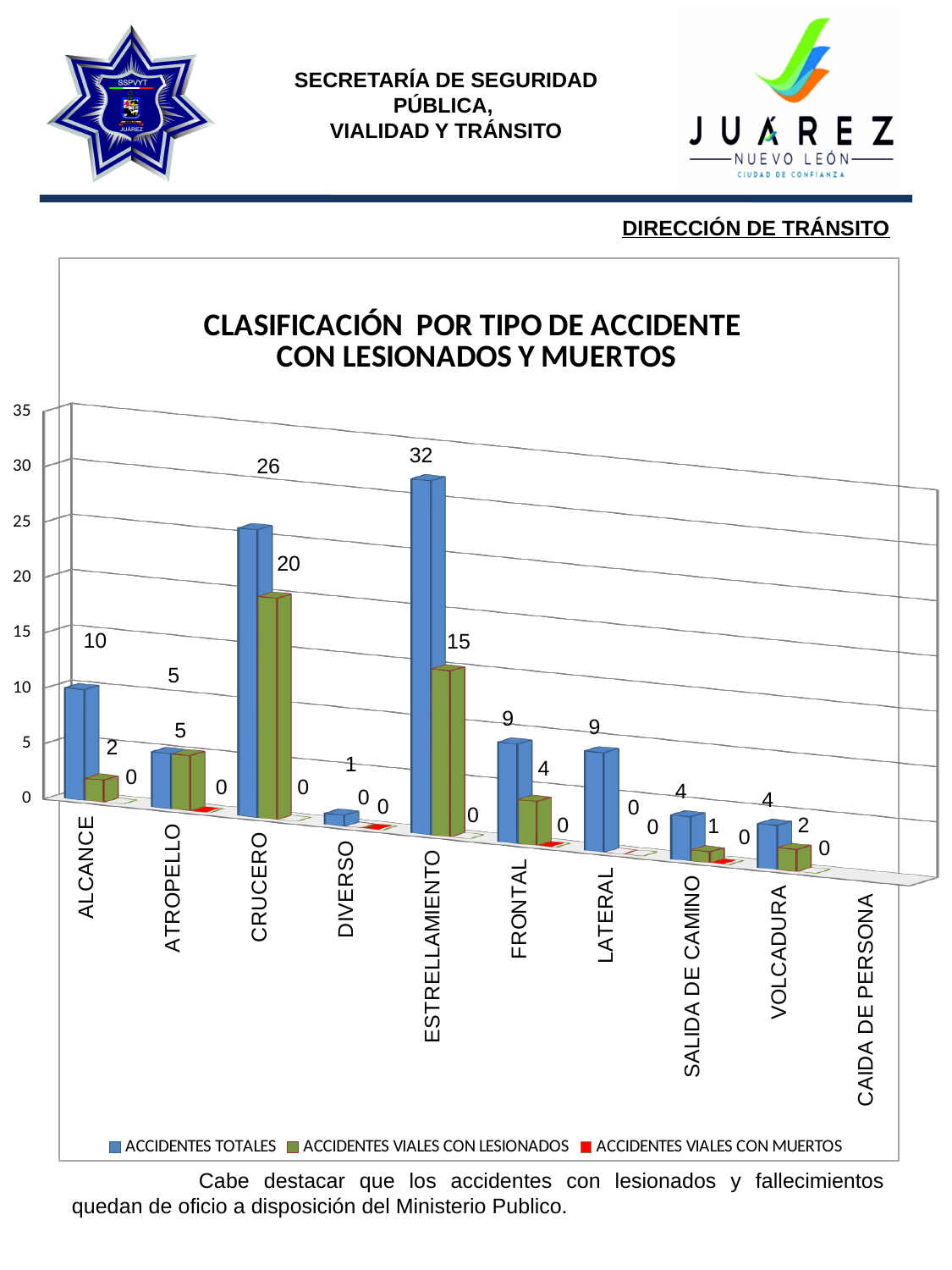
What is the value of ACCIDENTES TOTALES for ESTRELLAMIENTO? 32 What is the value of ACCIDENTES VIALES CON LESIONADOS for ATROPELLO? 5 What is the value of ACCIDENTES VIALES CON LESIONADOS for CRUCERO? 20 How many series does the legend list? 3 What is the difference in ACCIDENTES TOTALES between ESTRELLAMIENTO and CRUCERO? 6 Which category has the highest value of ACCIDENTES TOTALES? ESTRELLAMIENTO What is the value of ACCIDENTES TOTALES for LATERAL? 9 What is the title of the chart? CLASIFICACIÓN POR TIPO DE ACCIDENTE CON LESIONADOS Y MUERTOS Which has a higher value of ACCIDENTES TOTALES, ALCANCE or FRONTAL? ALCANCE How many accident categories are shown on the x axis? 10 What is the difference between ACCIDENTES TOTALES and ACCIDENTES VIALES CON LESIONADOS for CRUCERO? 6 What kind of chart is shown on the slide? bar chart